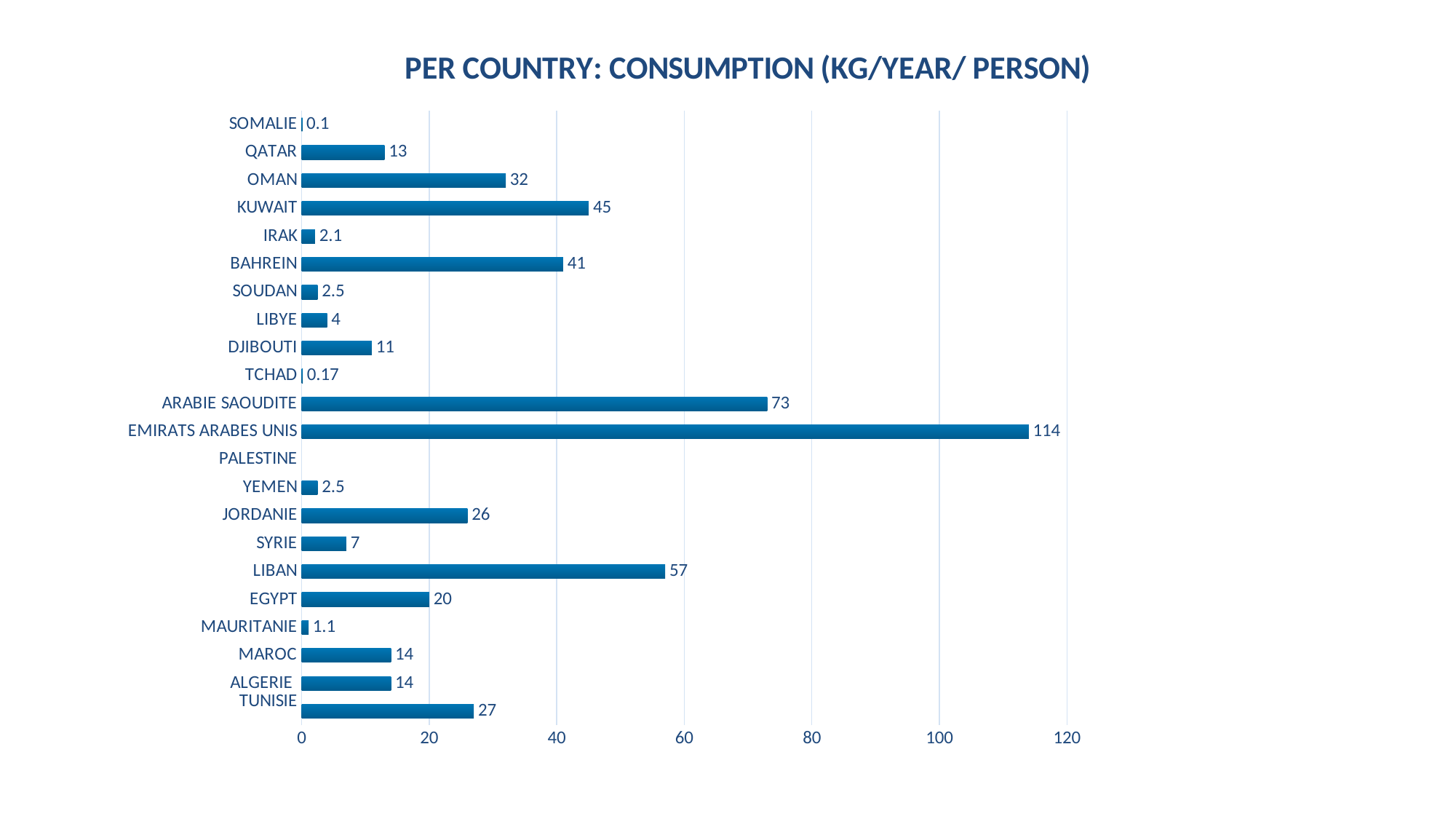
How many countries are listed on the chart? 22 What kind of chart is shown on the slide? Bar chart What is the difference in consumption between ARABIE SAOUDITE and KUWAIT? 28 Is the consumption value for LIBAN greater or less than 40? greater Which has a higher consumption, BAHREIN or OMAN? BAHREIN What is the title of the chart? PER COUNTRY: CONSUMPTION (KG/YEAR/ PERSON) What is the consumption value for TCHAD? 0.17 What is the consumption value for EMIRATS ARABES UNIS? 114 Which country on the chart has no bar or value shown? PALESTINE What is the difference in consumption between TUNISIE and MAROC? 13 Which country has the highest consumption? EMIRATS ARABES UNIS What is the consumption value for LIBAN? 57